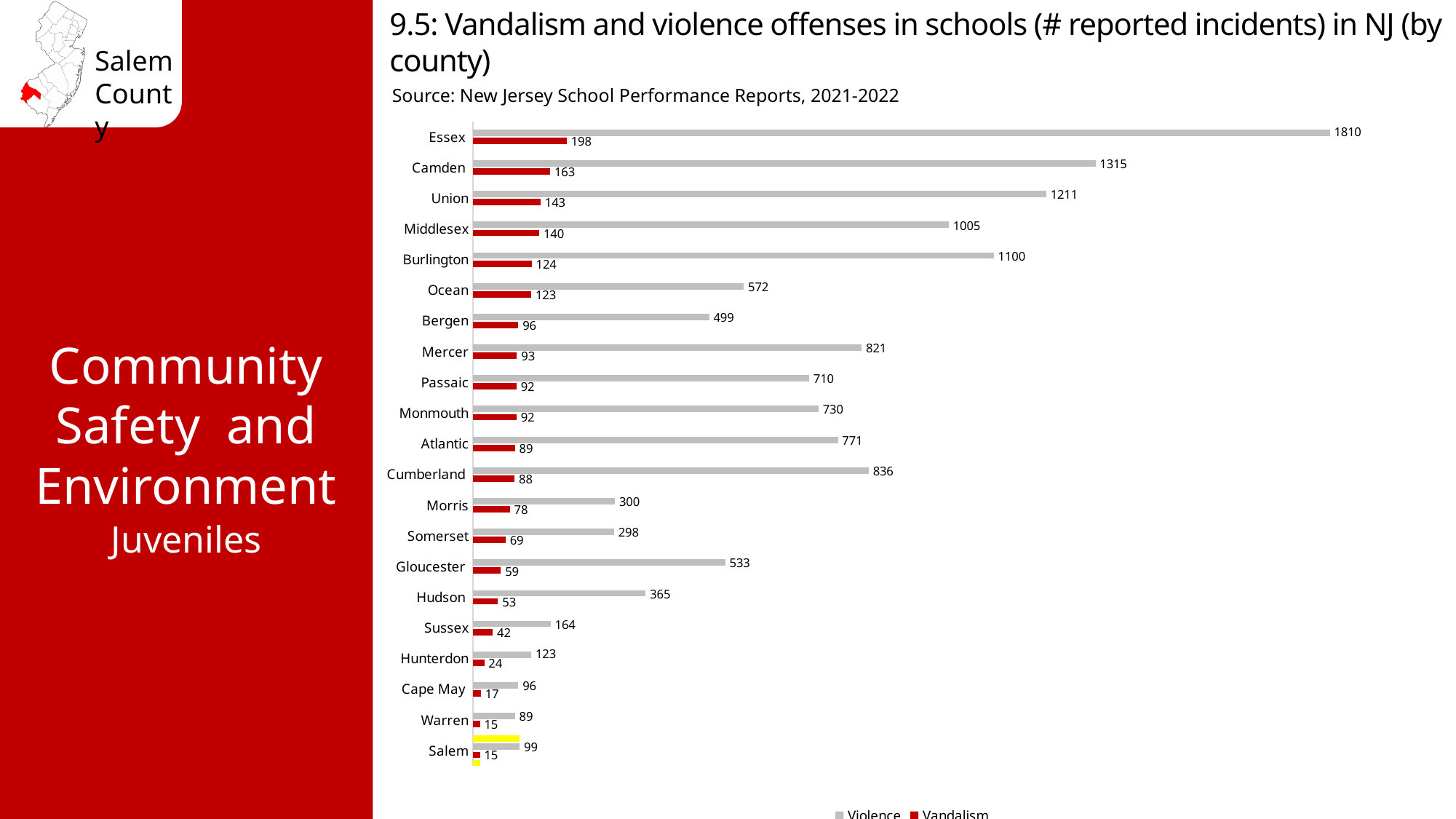
Which county has the highest number of Vandalism incidents? Essex What is the difference between Violence and Vandalism incidents in Salem county? 84 Which county has the lowest number of Violence incidents? Warren Which county has more Violence incidents, Burlington or Middlesex? Burlington How many counties are shown in the chart? 21 What is the number of Vandalism incidents reported for Salem county? 15 What is the difference between the Violence incidents in Essex and Camden? 495 How many series does the legend list? 2 What kind of chart is shown on the slide? Bar chart Which county has the highest number of Violence incidents? Essex What is the number of Vandalism incidents reported for Hunterdon county? 24 What is the number of Violence incidents reported for Essex county? 1810